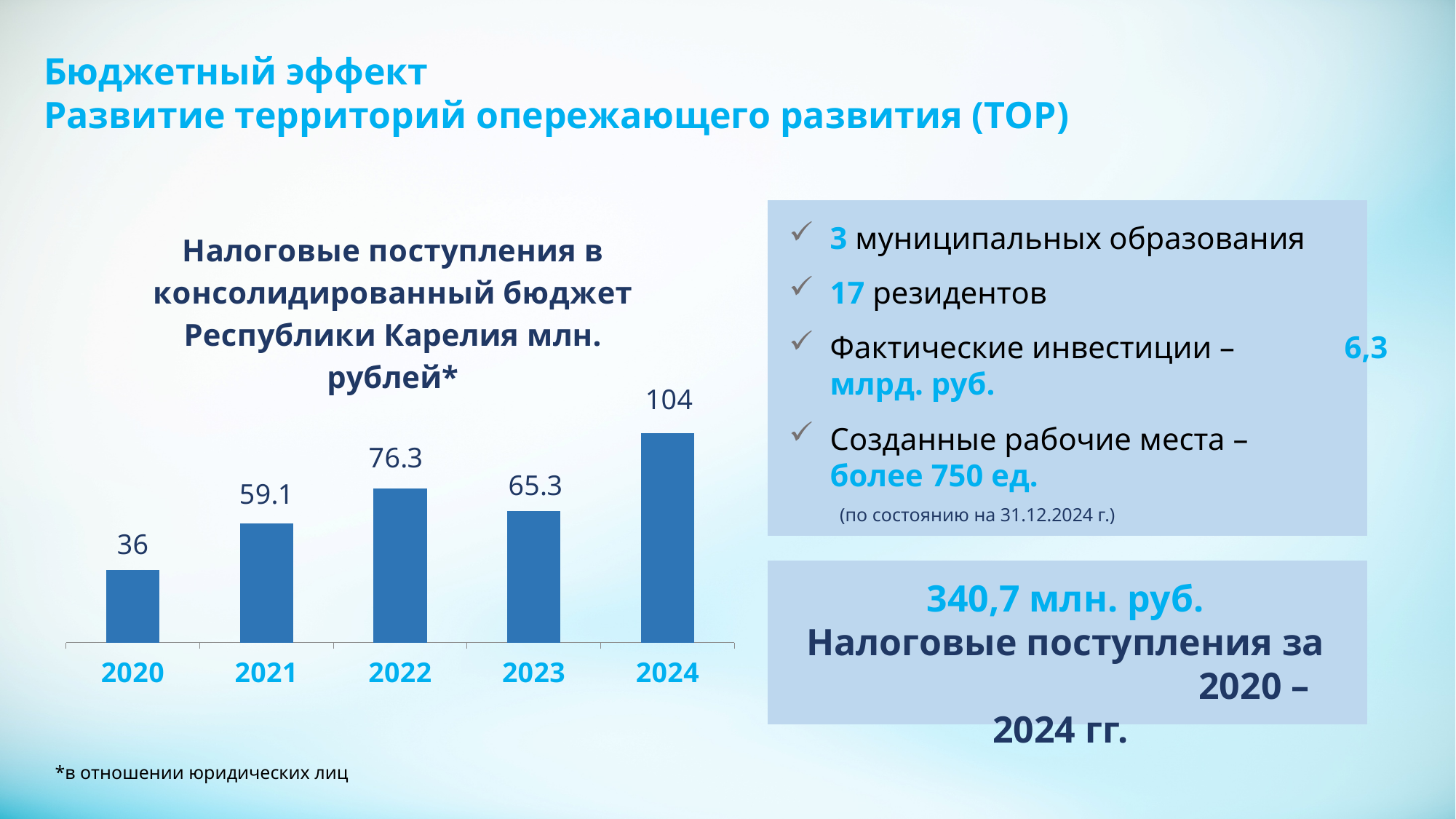
Which year has the lowest value? 2020 What is the difference between the values for 2024 and 2023? 38.7 What is the title of the chart? Налоговые поступления в консолидированный бюджет Республики Карелия млн. рублей* What is the value for 2022? 76.3 Does the value rise or fall from 2022 to 2023? fall What is the value for 2024? 104 What is the value for 2020? 36 How many years are shown on the x axis? 5 What kind of chart is this? bar chart What is the difference between the values for 2022 and 2021? 17.2 Which year has the highest value? 2024 Which is larger, the value for 2022 or the value for 2023? 2022